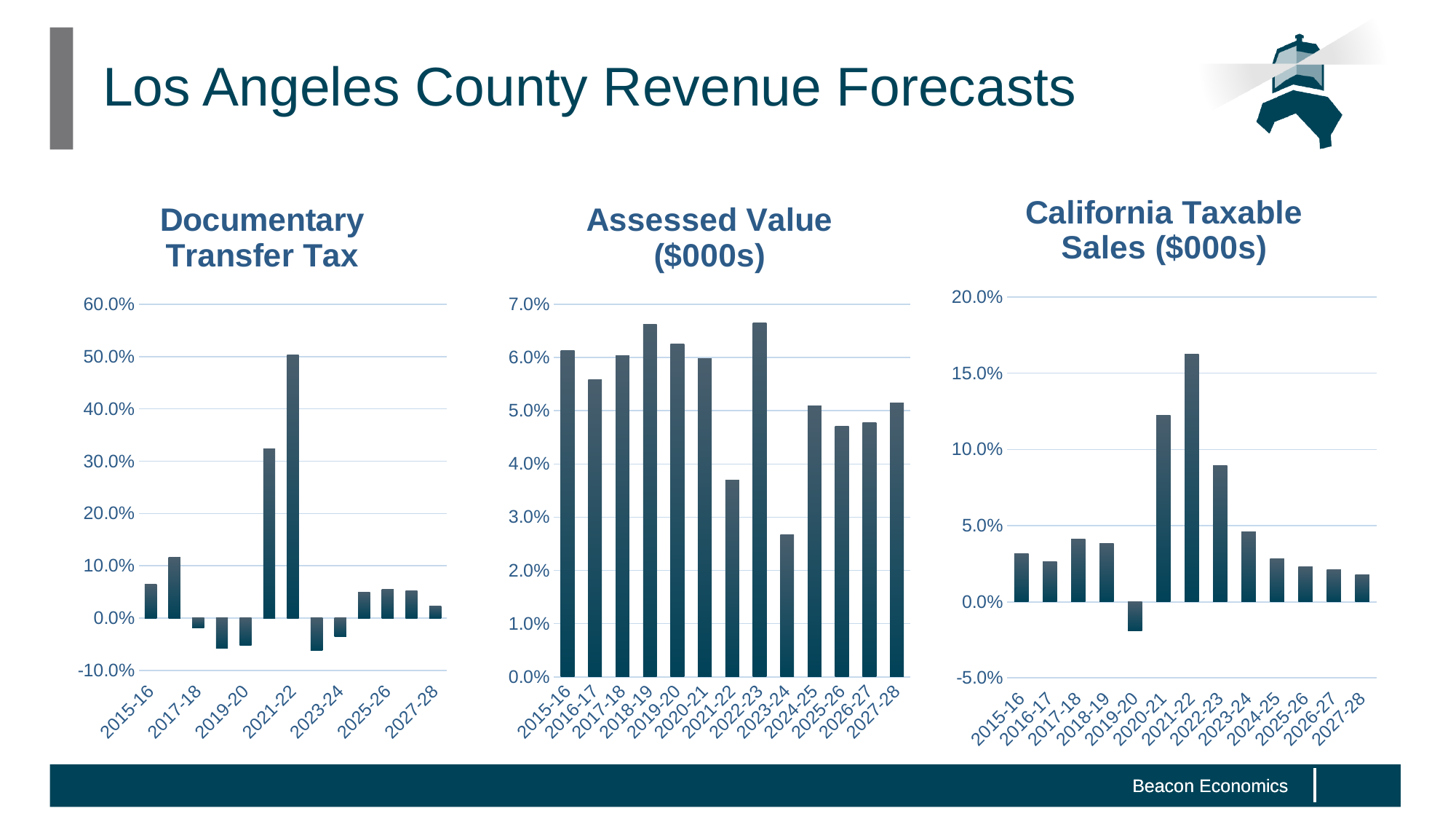
In the Assessed Value ($000s) chart, how many fiscal years are plotted? 13 In the Assessed Value ($000s) chart, which is larger, the value for 2015-16 or 2016-17? 2015-16 In the California Taxable Sales ($000s) chart, which fiscal year has the highest value? 2021-22 In the Assessed Value ($000s) chart, is the value for 2021-22 greater or less than 4.0%? less How many charts are shown on the slide? 3 In the California Taxable Sales ($000s) chart, which fiscal year has the lowest value? 2019-20 In the Documentary Transfer Tax chart, is the value for 2021-22 greater or less than 40.0%? greater What kind of chart is the Documentary Transfer Tax chart? bar chart In the Documentary Transfer Tax chart, which fiscal year has the highest value? 2021-22 In the California Taxable Sales ($000s) chart, do the values rise or fall from 2022-23 to 2027-28? fall In the Assessed Value ($000s) chart, which fiscal year has the lowest value? 2023-24 In the Documentary Transfer Tax chart, is the value for 2016-17 greater or less than 20.0%? less